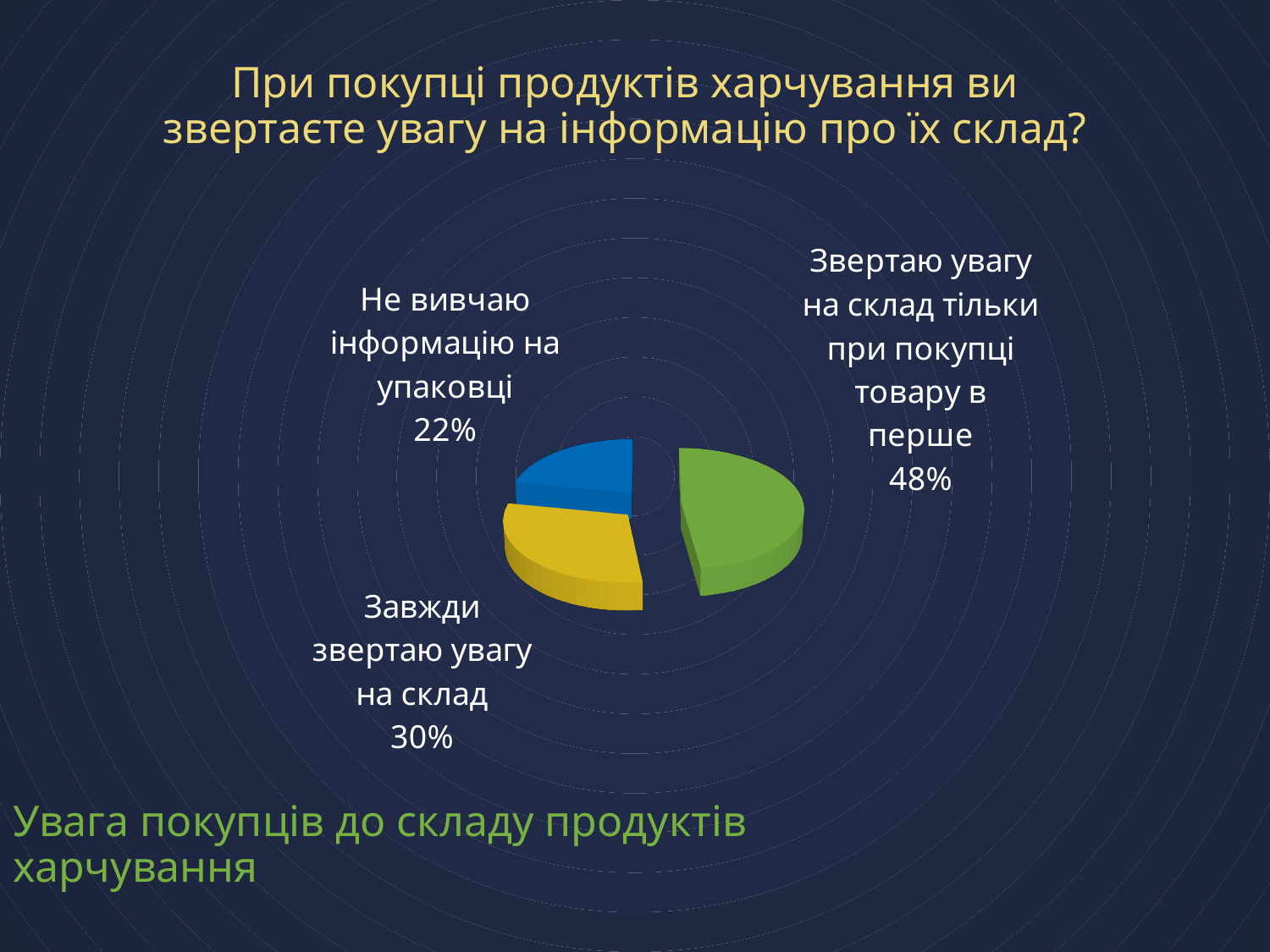
What is the difference in percentage points between "Завжди звертаю увагу на склад" and "Не вивчаю інформацію на упаковці"? 8 percentage points Which answer has the smallest share of the pie? Не вивчаю інформацію на упаковці What kind of chart is shown on the slide? pie chart What share of respondents answered "Не вивчаю інформацію на упаковці"? 22% Which is larger: the share for "Завжди звертаю увагу на склад" or for "Не вивчаю інформацію на упаковці"? Завжди звертаю увагу на склад Which answer has the largest share of the pie? Звертаю увагу на склад тільки при покупці товару в перше What share of respondents answered "Звертаю увагу на склад тільки при покупці товару в перше"? 48% How many slices does the pie chart have? 3 What colour is the slice for "Звертаю увагу на склад тільки при покупці товару в перше"? green What share of respondents answered "Завжди звертаю увагу на склад"? 30% What is the difference in percentage points between "Звертаю увагу на склад тільки при покупці товару в перше" and "Завжди звертаю увагу на склад"? 18 percentage points